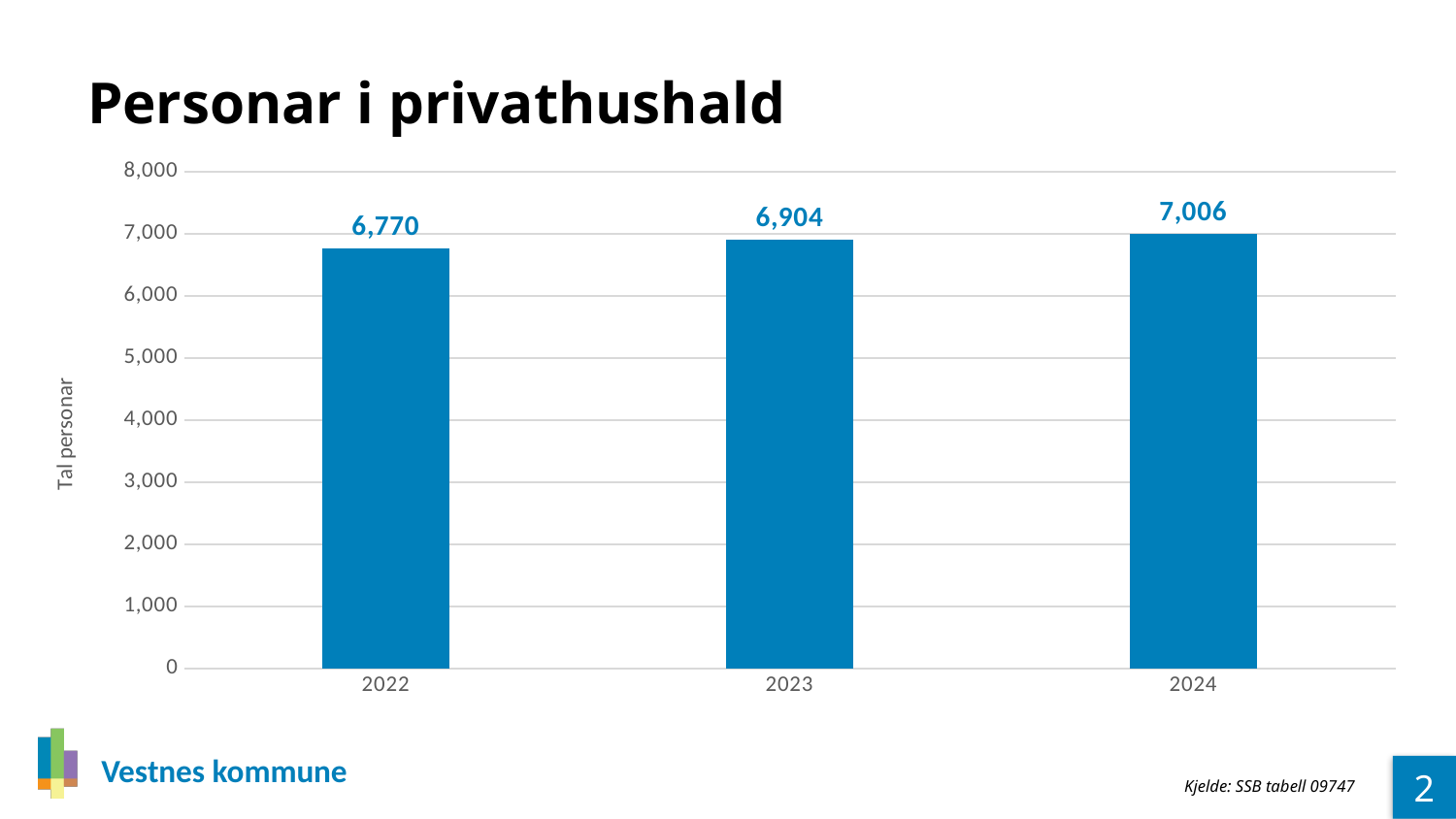
What kind of chart is shown? bar chart What is the difference between the values for 2023 and 2022? 134 Which year has the lowest value? 2022 What is the value for 2023? 6,904 Do the values rise or fall from 2022 to 2024? rise What is the difference between the values for 2024 and 2022? 236 What is the value for 2022? 6,770 Which is larger, the value for 2023 or the value for 2024? 2024 Which year has the highest value? 2024 How many years are shown on the x axis? 3 Is the value for 2024 greater or less than 7,000? greater What is the value for 2024? 7,006